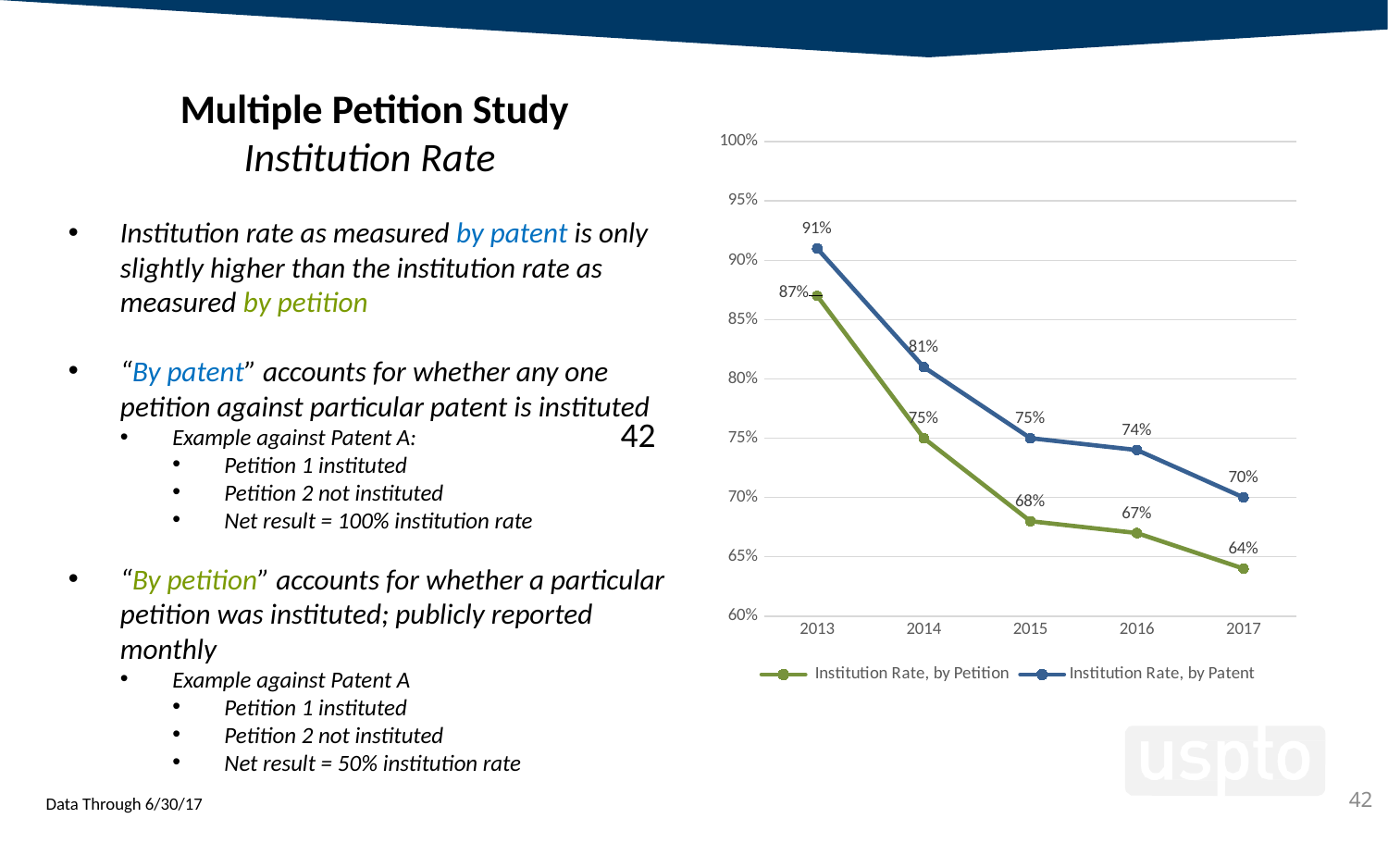
Which is larger in 2015: the Institution Rate, by Patent or the Institution Rate, by Petition? Institution Rate, by Patent How many series does the chart's legend list? 2 Which year has the lowest Institution Rate, by Petition? 2017 What kind of chart is shown on the slide? Line chart How many years are plotted on the x axis of the chart? 5 What is the difference between the Institution Rate, by Patent and the Institution Rate, by Petition in 2014? 6% What is the Institution Rate, by Patent for 2016? 74% What is the Institution Rate, by Patent for 2013? 91% Does the Institution Rate, by Petition rise or fall from 2013 to 2017? Fall What is the Institution Rate, by Petition for 2015? 68% Which year has the highest Institution Rate, by Patent? 2013 What is the Institution Rate, by Petition for 2017? 64%